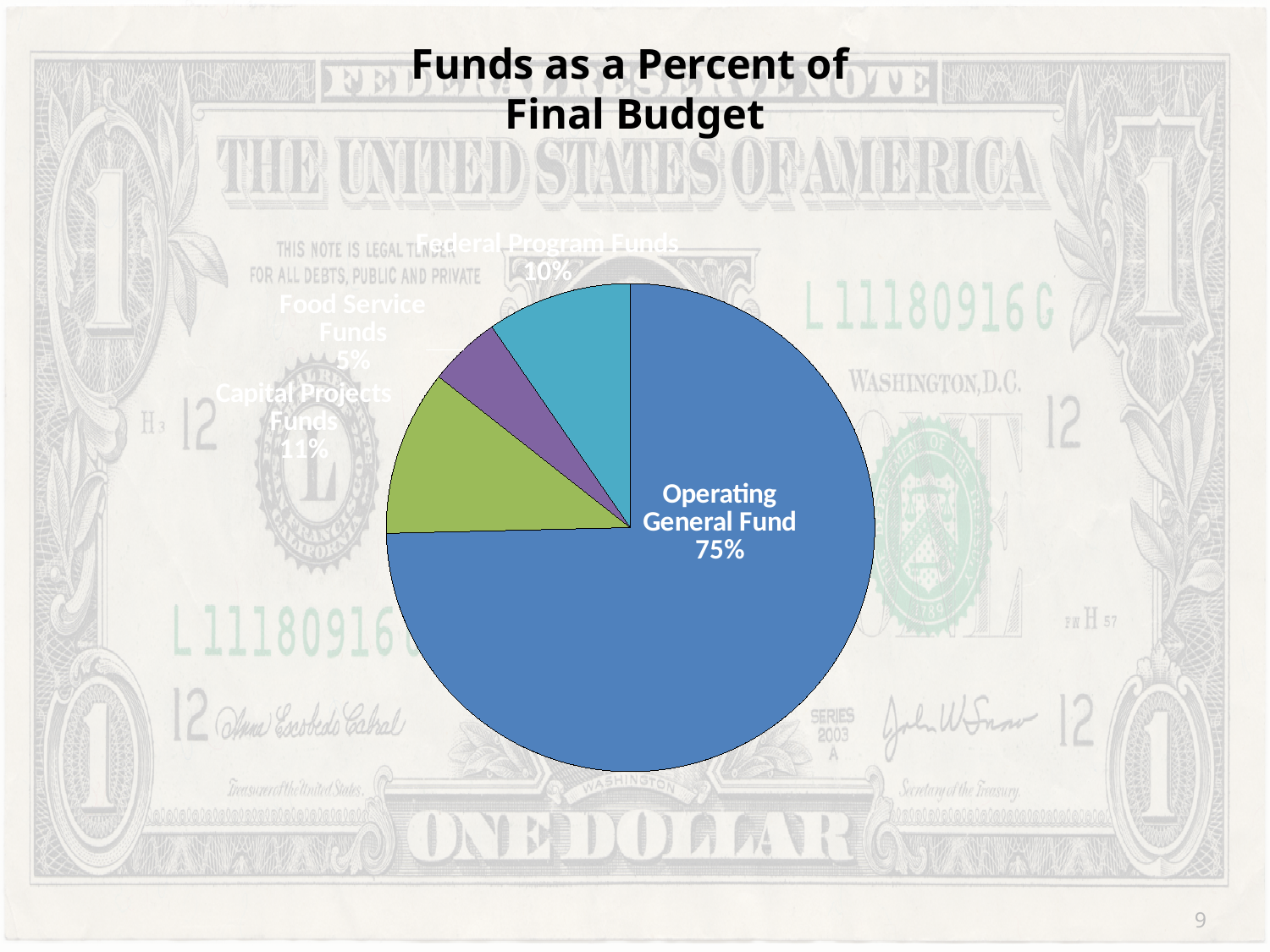
What percentage of the final budget is Federal Program Funds? 10% What colour is the Operating General Fund slice? Blue Which is larger, Capital Projects Funds or Federal Program Funds? Capital Projects Funds What is the difference in percentage points between the Operating General Fund and Capital Projects Funds? 64 Which fund has the largest share of the final budget? Operating General Fund What percentage of the final budget is Food Service Funds? 5% What is the title of the chart? Funds as a Percent of Final Budget What kind of chart is shown on the slide? Pie chart Which fund has the smallest share of the final budget? Food Service Funds What percentage of the final budget is Capital Projects Funds? 11% How many slices does the pie chart have? 4 What percentage of the final budget is the Operating General Fund? 75%